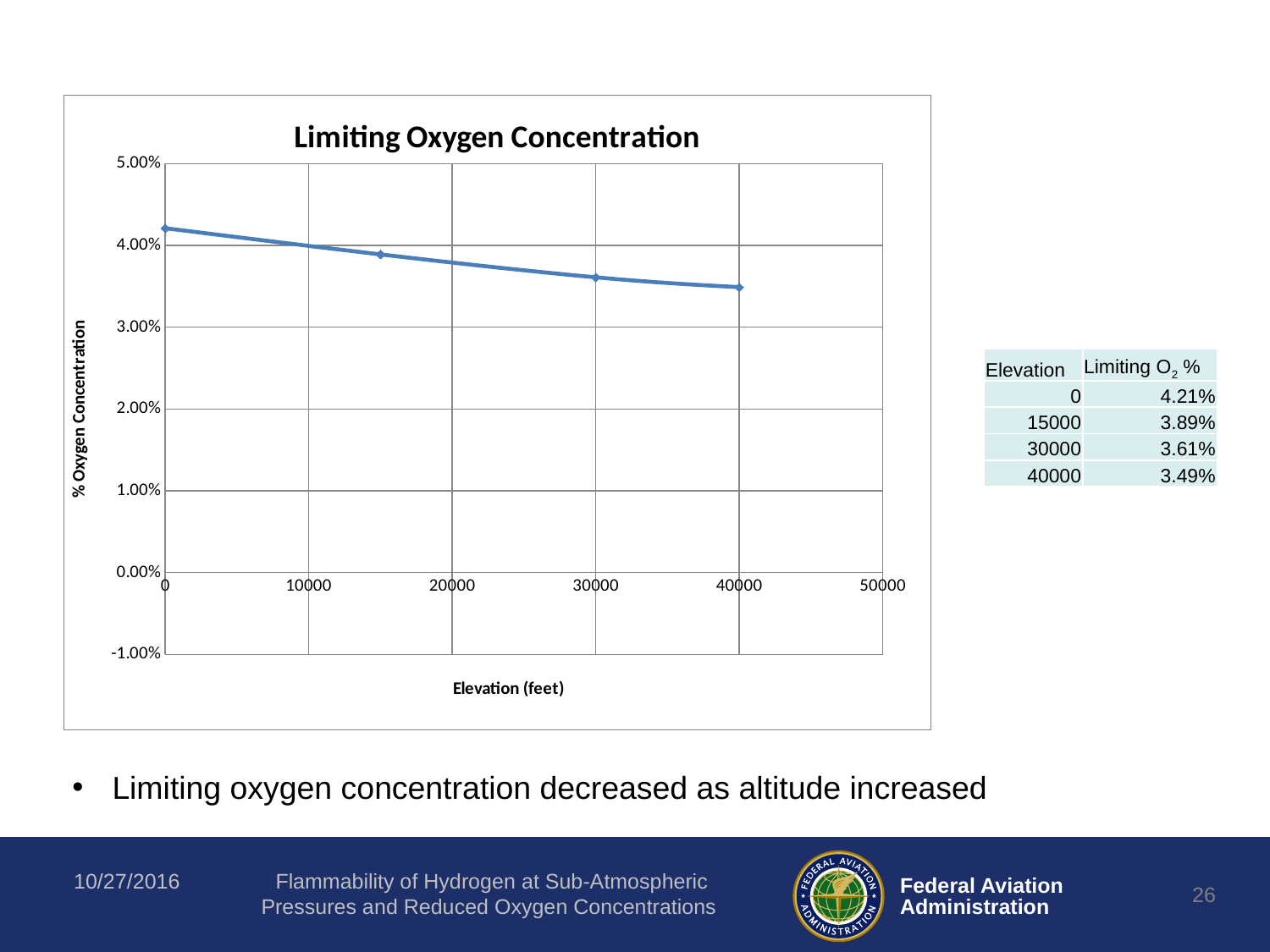
At which elevation is the limiting oxygen concentration lowest? 40000 What is the limiting oxygen concentration at an elevation of 15000 feet? 3.89% What is the title of the chart? Limiting Oxygen Concentration What is the limiting oxygen concentration at an elevation of 0 feet? 4.21% What is the limiting oxygen concentration at an elevation of 40000 feet? 3.49% At which elevation is the limiting oxygen concentration highest? 0 What is the difference between the limiting oxygen concentration at 0 feet and at 40000 feet? 0.72% Does the limiting oxygen concentration rise or fall as elevation increases? fall How many data points are plotted on the chart? 4 What type of chart is shown on the slide? line chart What is the limiting oxygen concentration at an elevation of 30000 feet? 3.61% Which is larger, the limiting oxygen concentration at 15000 feet or at 30000 feet? 15000 feet